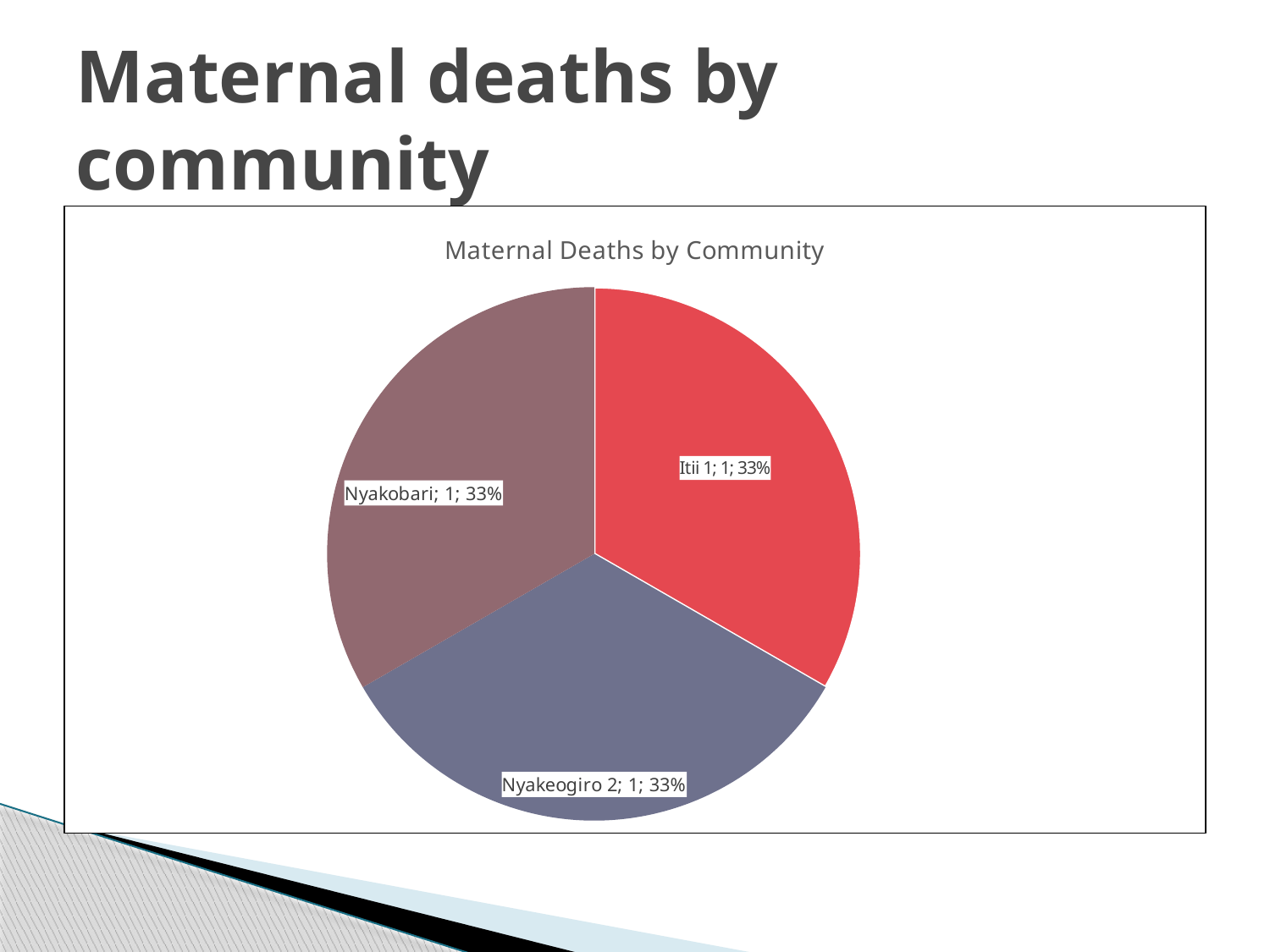
What share of the pie does Nyakeogiro 2 represent? 33% How many slices does the pie chart have? 3 What is the value for Itii 1? 1 What is the title of the chart? Maternal Deaths by Community What is the value for Nyakobari? 1 What is the total of the values across all three communities? 3 What is the difference between the values for Itii 1 and Nyakobari? 0 What kind of chart is shown on the slide? pie chart What share of the pie does Itii 1 represent? 33% Which slice is coloured red? Itii 1 What share of the pie does Nyakobari represent? 33% What is the value for Nyakeogiro 2? 1